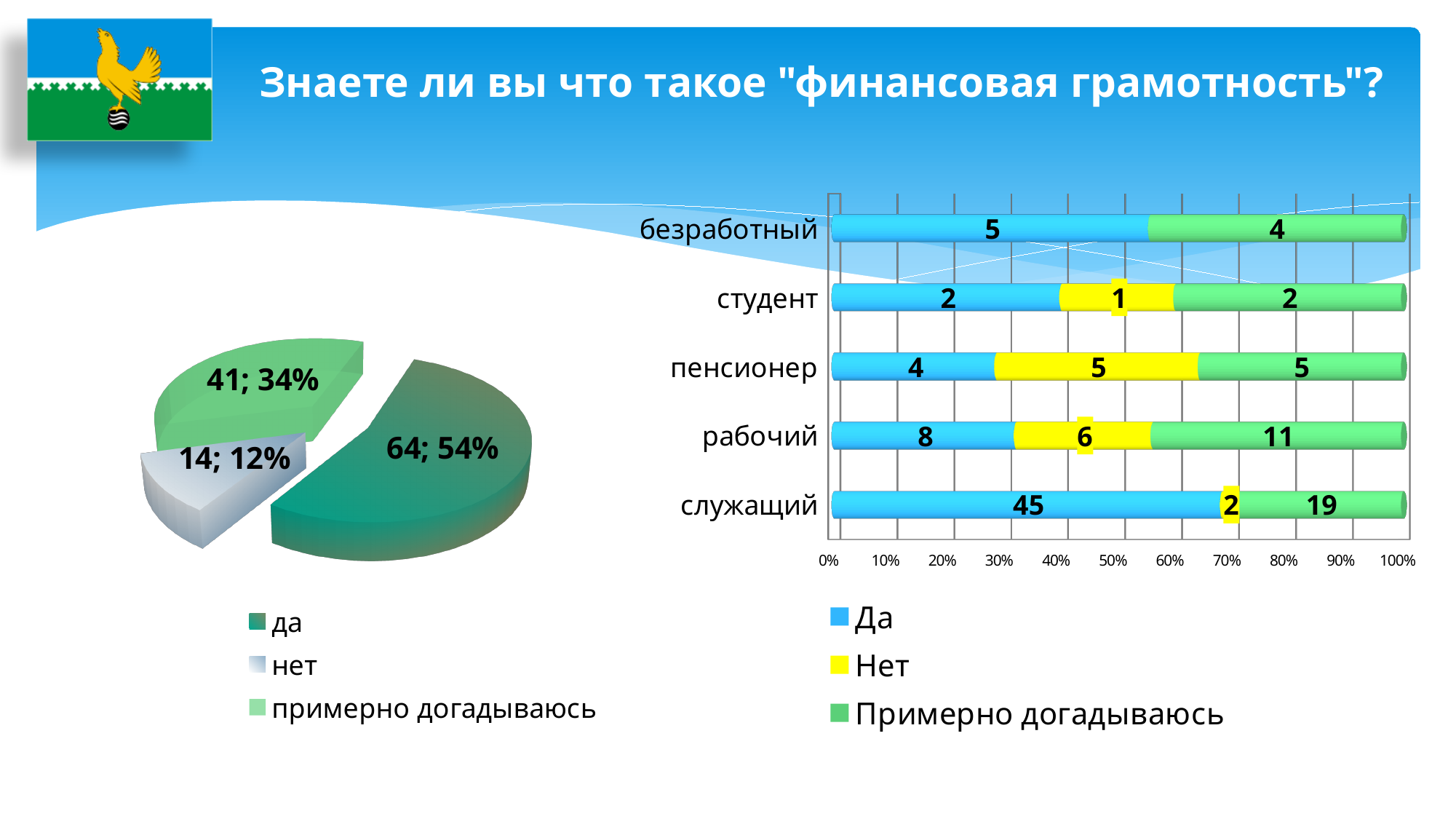
On the bar chart on the right, what is the difference between the "Да" value for "служащий" and the "Да" value for "рабочий"? 37 On the bar chart on the right, which category has the highest "Да" value? служащий On the bar chart on the right, what is the "Примерно догадываюсь" value for "рабочий"? 11 On the bar chart on the right, what is the total of the bar for "студент"? 5 On the pie chart on the left, how many entries does the legend list? 3 On the pie chart on the left, what share of the pie does "нет" have? 12% What kind of chart is shown on the right side of the slide? bar chart On the bar chart on the right, how many categories are shown on the vertical axis? 5 On the pie chart on the left, which category has the smallest slice? нет On the bar chart on the right, what is the "Да" value for "служащий"? 45 On the pie chart on the left, what value and share are shown for "да"? 64; 54% On the bar chart on the right, what is the "Нет" value for "пенсионер"? 5